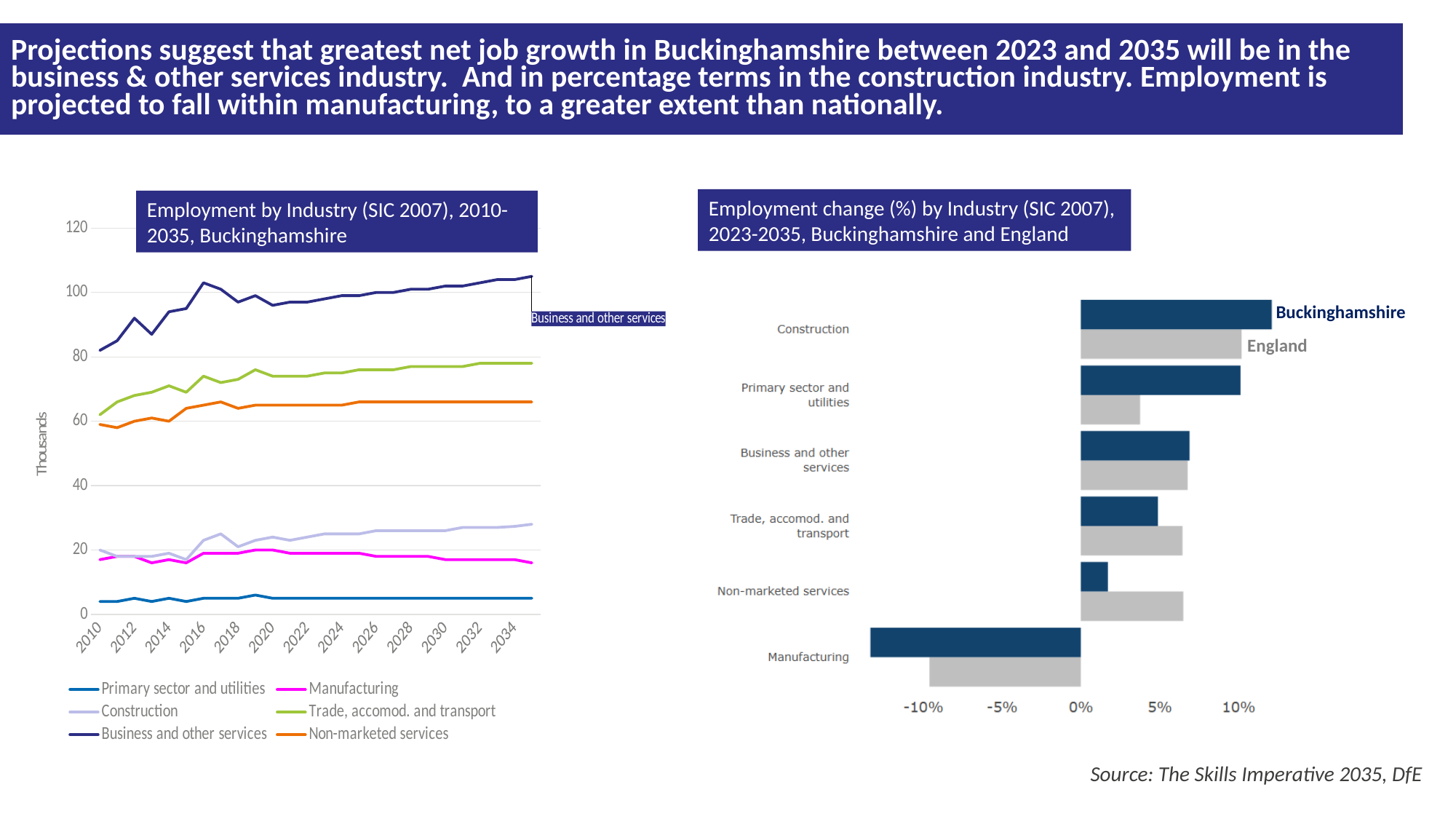
In the 'Employment change (%) by Industry' chart, how many industry categories are shown? 6 In the 'Employment by Industry (SIC 2007), 2010-2035, Buckinghamshire' chart, is the value for Business and other services in 2034 greater or less than 100? greater In the 'Employment change (%) by Industry' chart, which industry has the lowest employment change for Buckinghamshire? Manufacturing In the 'Employment by Industry (SIC 2007), 2010-2035, Buckinghamshire' chart, does employment in Business and other services generally rise or fall from 2010 to 2035? Rise In the 'Employment change (%) by Industry' chart, which industry has the highest employment change for Buckinghamshire? Construction In the 'Employment by Industry (SIC 2007), 2010-2035, Buckinghamshire' chart, which industry has the highest employment throughout the period? Business and other services What kind of chart is the 'Employment change (%) by Industry (SIC 2007), 2023-2035, Buckinghamshire and England' chart? Bar chart In the 'Employment change (%) by Industry' chart, for Non-marketed services, which is larger: the Buckinghamshire value or the England value? England In the 'Employment by Industry (SIC 2007), 2010-2035, Buckinghamshire' chart, how many series does the legend list? 6 In the 'Employment by Industry (SIC 2007), 2010-2035, Buckinghamshire' chart, which industry has the lowest employment throughout the period? Primary sector and utilities In the 'Employment by Industry (SIC 2007), 2010-2035, Buckinghamshire' chart, is the value for Trade, accomod. and transport in 2034 greater or less than 80? less What kind of chart is the 'Employment by Industry (SIC 2007), 2010-2035, Buckinghamshire' chart? Line chart